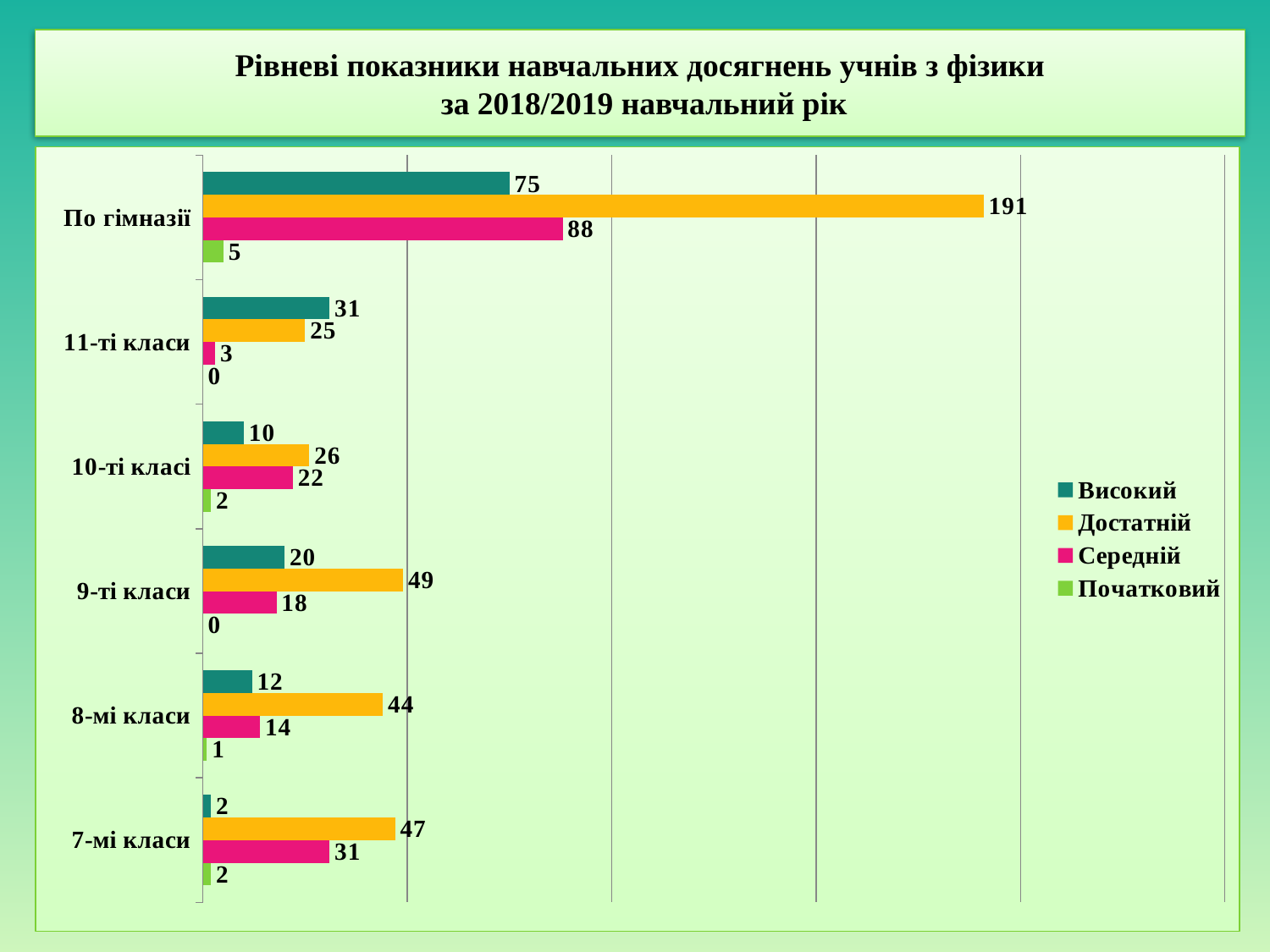
What is the value of Середній for 7-мі класи? 31 What type of chart is shown on the slide? Bar chart Which category has the highest Достатній value? По гімназії What is the value of Високий for 11-ті класи? 31 Which is larger for 10-ті класі: Достатній or Середній? Достатній How many categories are shown on the vertical axis? 6 How many series does the legend list? 4 Which series is shown in pink? Середній What is the difference between the Достатній and Середній values for По гімназії? 103 What is the value of Достатній for По гімназії? 191 Which category has the lowest Високий value? 7-мі класи What is the value of Початковий for 8-мі класи? 1